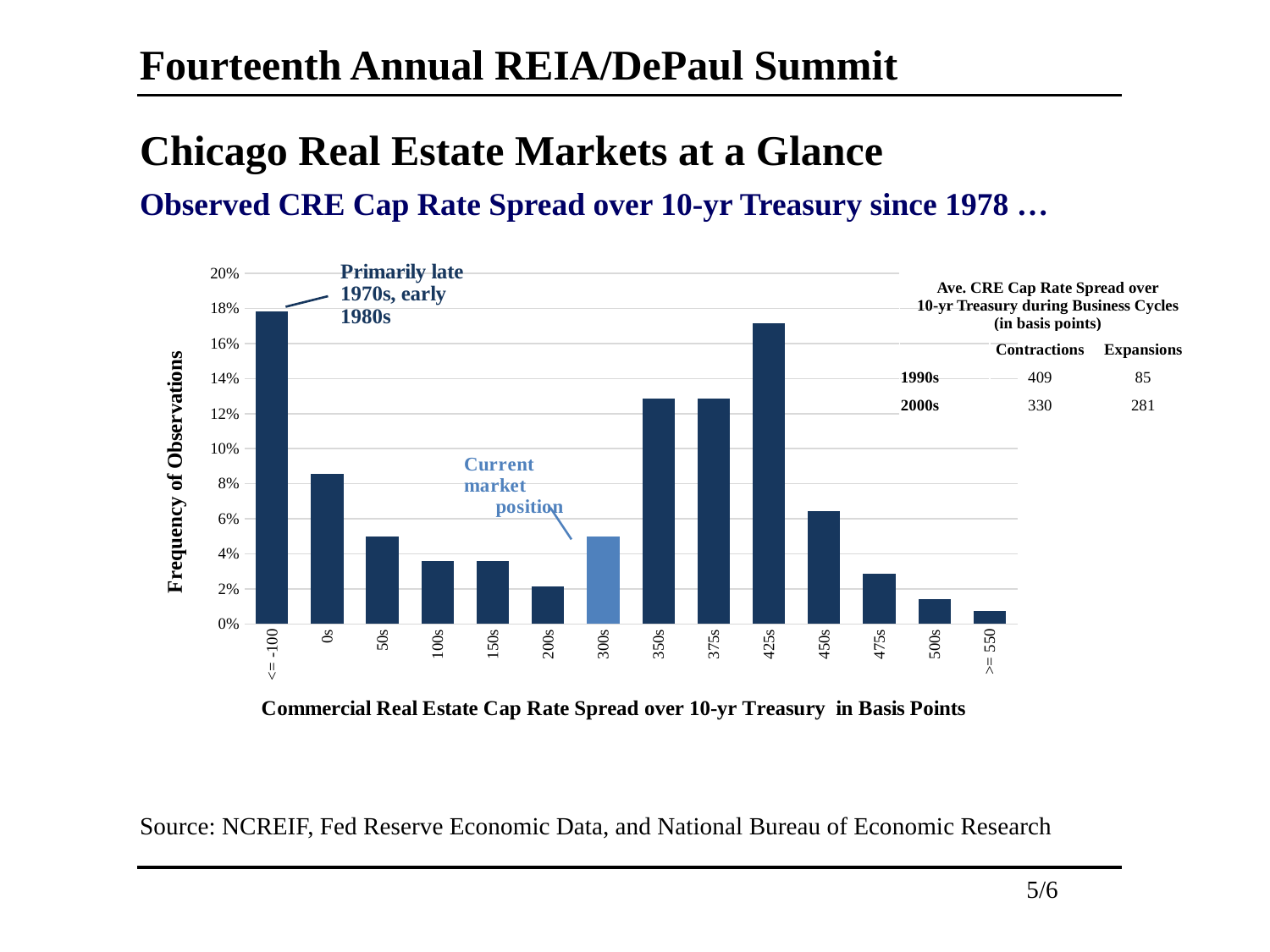
Is the value for 0s greater or less than 10%? less What is the title of the chart's y axis? Frequency of Observations Is the value for 300s greater or less than 6%? less Is the value for 425s greater or less than 16%? greater Which category has the lowest frequency of observations? >= 550 Which category is labeled as the current market position on the chart? 300s How many categories are shown along the x axis of the chart? 14 What kind of chart is shown on the slide? bar chart Which has a higher frequency of observations, 0s or 50s? 0s